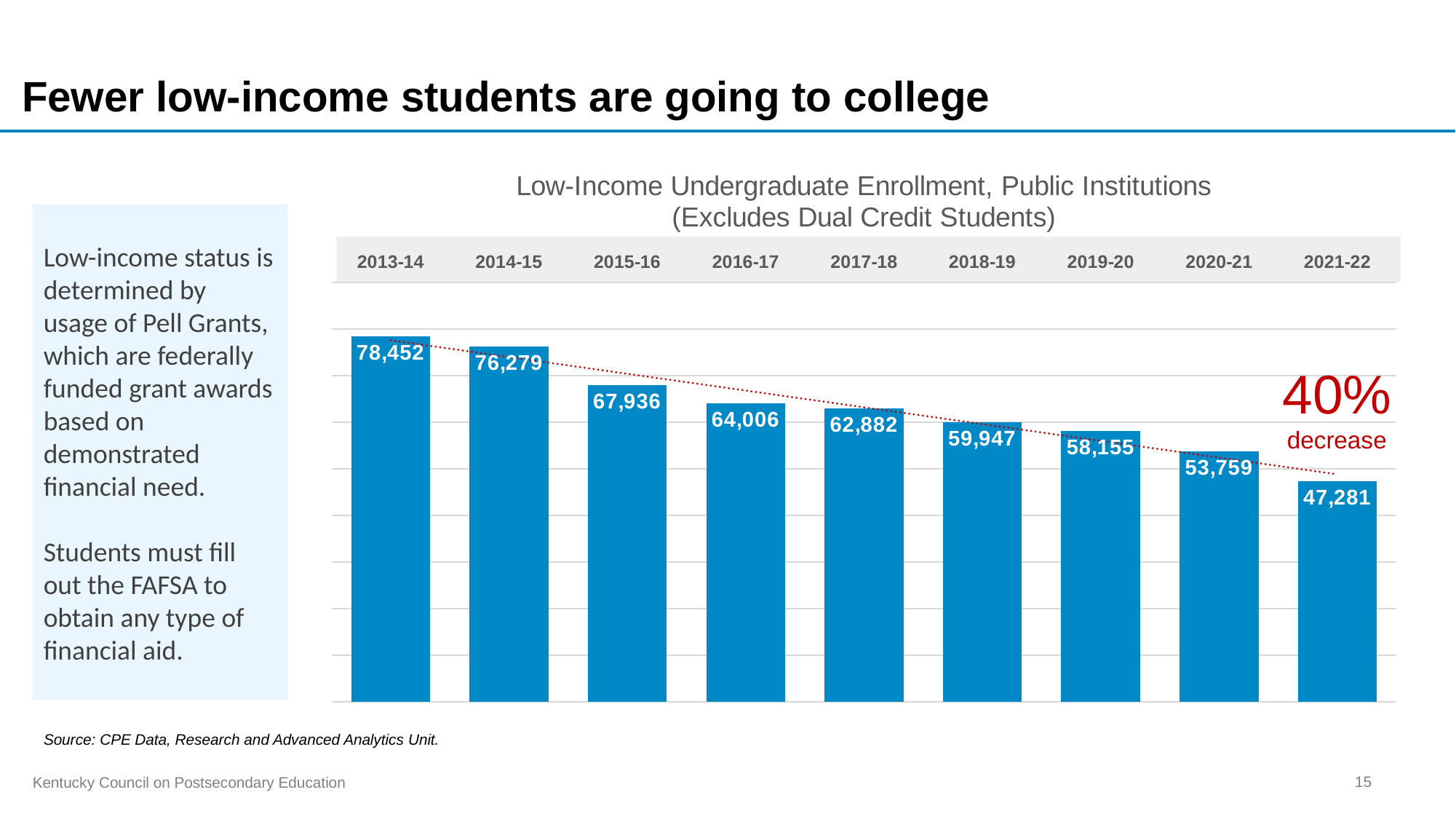
What is the low-income undergraduate enrollment for 2021-22? 47,281 How many academic years are shown in the chart? 9 What is the difference in enrollment between 2013-14 and 2021-22? 31,171 Does low-income undergraduate enrollment rise or fall from 2013-14 to 2021-22? Fall What is the low-income undergraduate enrollment for 2017-18? 62,882 Which academic year has the highest low-income undergraduate enrollment? 2013-14 Which academic year has the lowest low-income undergraduate enrollment? 2021-22 What is the low-income undergraduate enrollment for 2013-14? 78,452 Which year has higher enrollment, 2018-19 or 2019-20? 2018-19 What is the difference in enrollment between 2015-16 and 2016-17? 3,930 What kind of chart is shown on the slide? Bar chart What percentage decrease is annotated on the chart? 40%